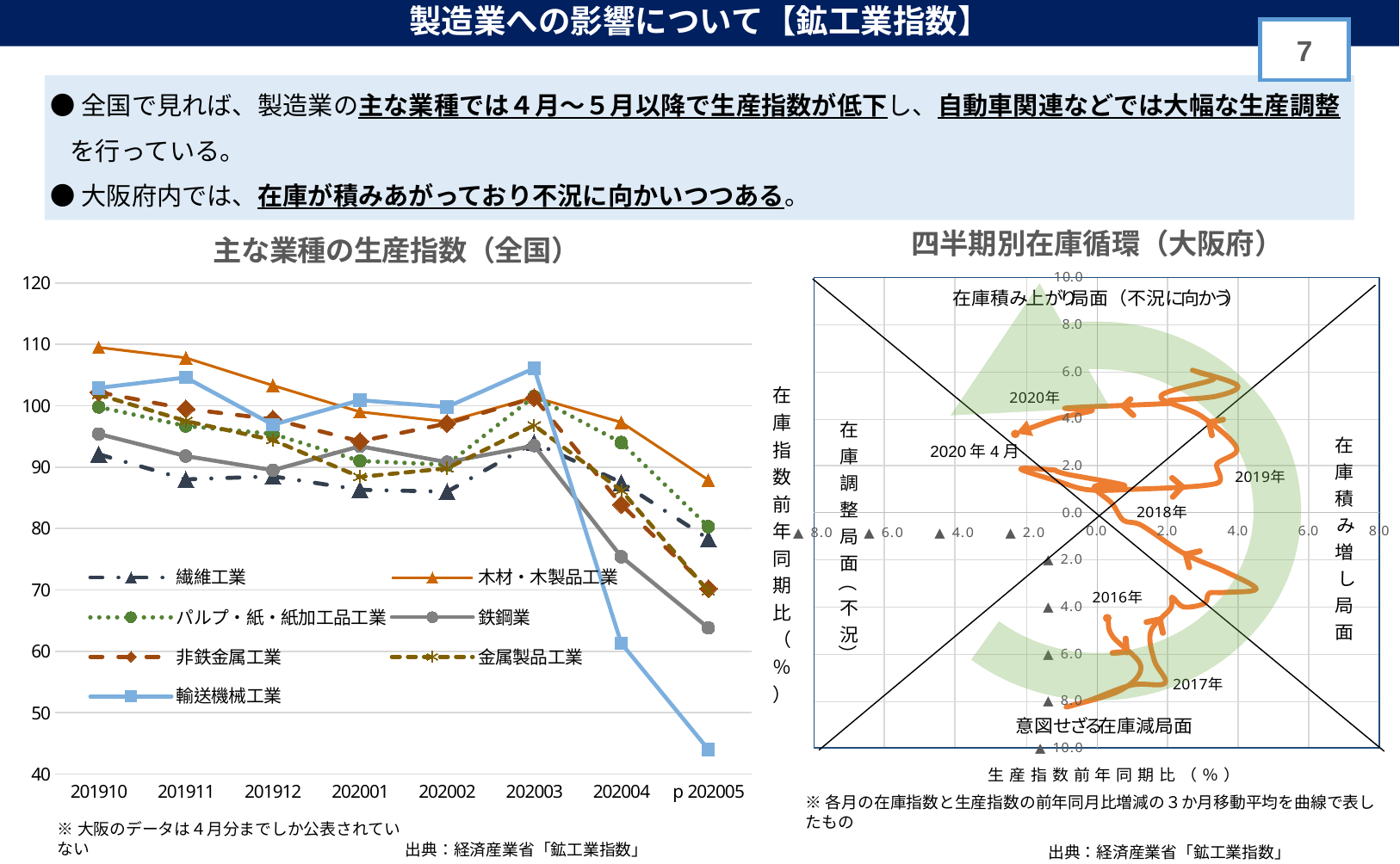
In the left chart 主な業種の生産指数（全国）, is the value for 輸送機械工業 at p 202005 greater or less than 50? less In the left chart 主な業種の生産指数（全国）, does the value for 輸送機械工業 rise or fall from 202003 to p 202005? fall In the left chart 主な業種の生産指数（全国）, which series has the highest value at p 202005? 木材・木製品工業 In the left chart 主な業種の生産指数（全国）, is the value for 木材・木製品工業 at 201910 greater or less than 100? greater What kind of chart is the left chart titled 主な業種の生産指数（全国）? line chart In the left chart 主な業種の生産指数（全国）, is the value for 鉄鋼業 at p 202005 greater or less than 70? less In the left chart 主な業種の生産指数（全国）, which series has the highest value at 201910? 木材・木製品工業 In the left chart 主な業種の生産指数（全国）, which series has the lowest value at p 202005? 輸送機械工業 In the left chart 主な業種の生産指数（全国）, how many series does the legend list? 7 What is the x-axis title of the right chart titled 四半期別在庫循環（大阪府）? 生産指数前年同期比（％） In the left chart 主な業種の生産指数（全国）, how many time points are shown on the x axis? 8 In the left chart 主な業種の生産指数（全国）, at 201910, which is larger: 木材・木製品工業 or 繊維工業? 木材・木製品工業